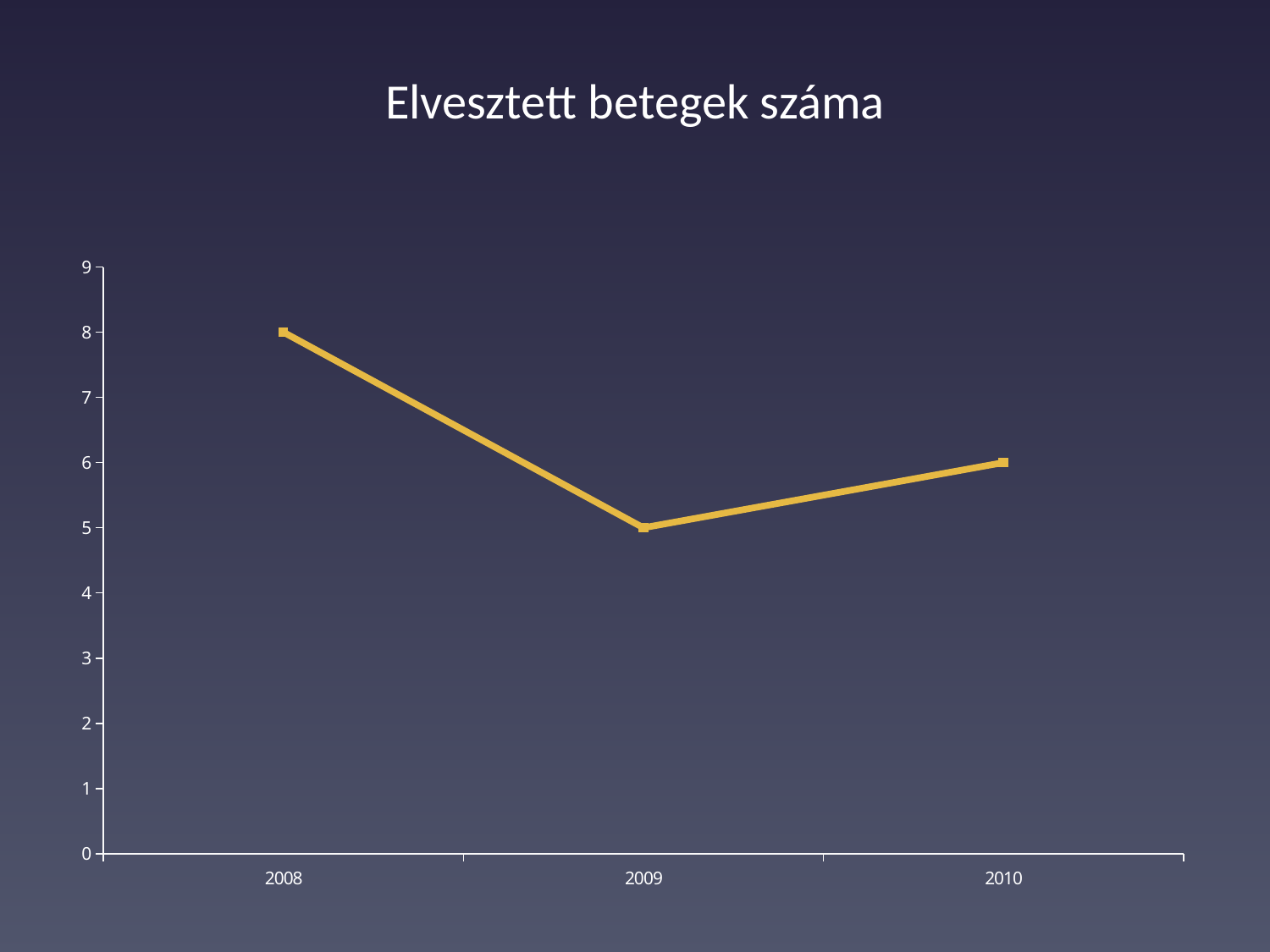
Which year has the highest value? 2008 Which is larger, the value for 2008 or the value for 2010? 2008 How many years are shown on the x axis? 3 What is the difference between the values for 2010 and 2009? 1 What is the difference between the values for 2008 and 2009? 3 What is the value for 2010? 6 What is the title of the chart? Elvesztett betegek száma What kind of chart is shown on the slide? line chart What is the value for 2008? 8 Which year has the lowest value? 2009 What is the value for 2009? 5 Is the value for 2009 greater or less than 7? less